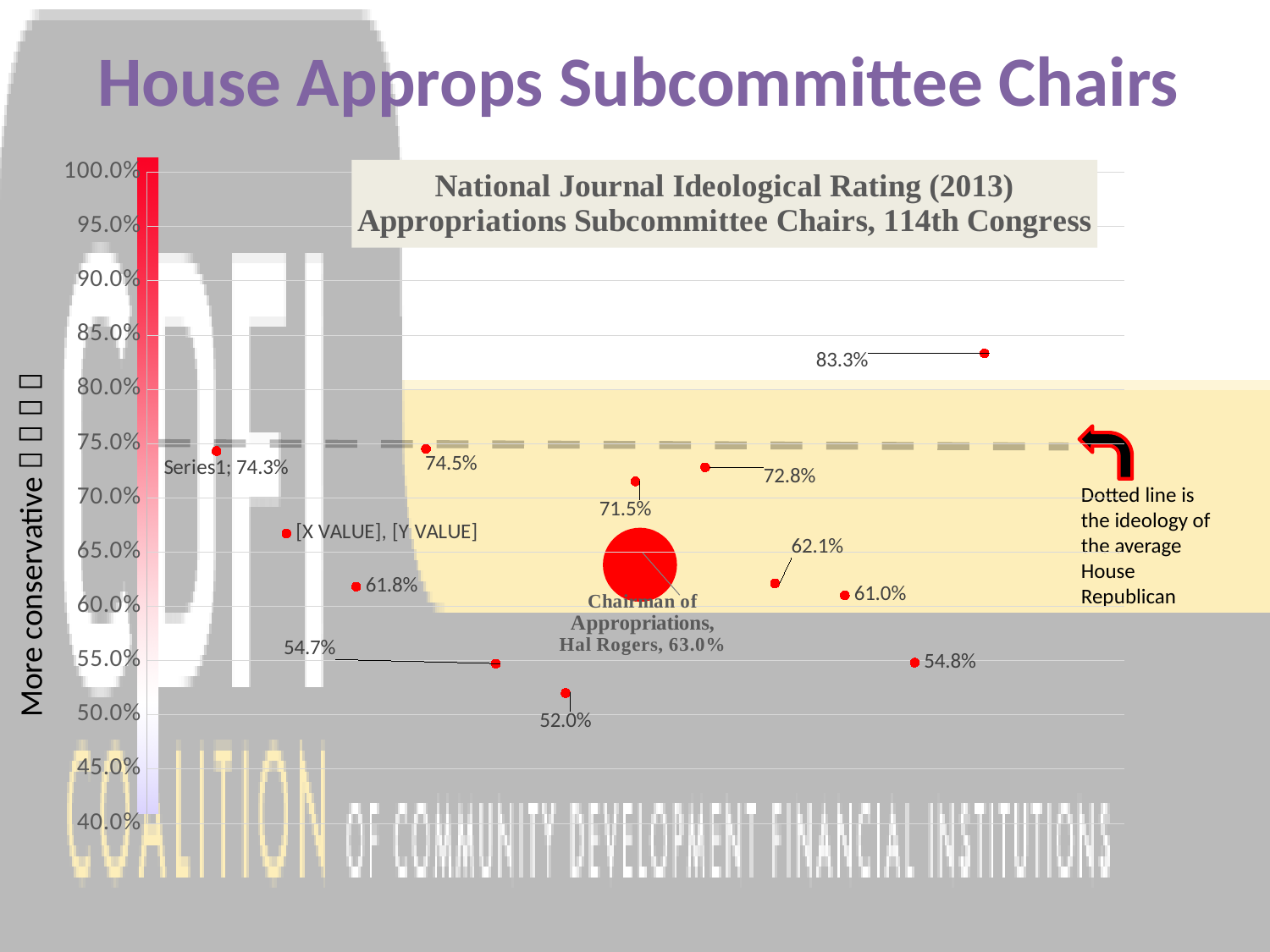
What is the title of the chart? National Journal Ideological Rating (2013) Appropriations Subcommittee Chairs, 114th Congress What is the lowest ideological rating plotted on the chart? 52.0% Which is larger, the point labeled 74.5% or the point labeled Series1; 74.3%? 74.5% What kind of chart is shown on the slide? Scatter chart What is the ideological rating shown for the Chairman of Appropriations, Hal Rogers? 63.0% What is the highest ideological rating plotted on the chart? 83.3% According to the annotation, what does the dotted line represent? The ideology of the average House Republican What is the difference between the highest plotted rating (83.3%) and the lowest plotted rating (52.0%)? 31.3 percentage points How much higher is the highest plotted rating (83.3%) than Hal Rogers' rating (63.0%)? 20.3 percentage points How many plotted points have a rating above 80.0%? 1 What is the lowest value shown on the vertical axis? 40.0% Is the value of the point labeled '[X VALUE], [Y VALUE]' greater or less than 65.0%? greater